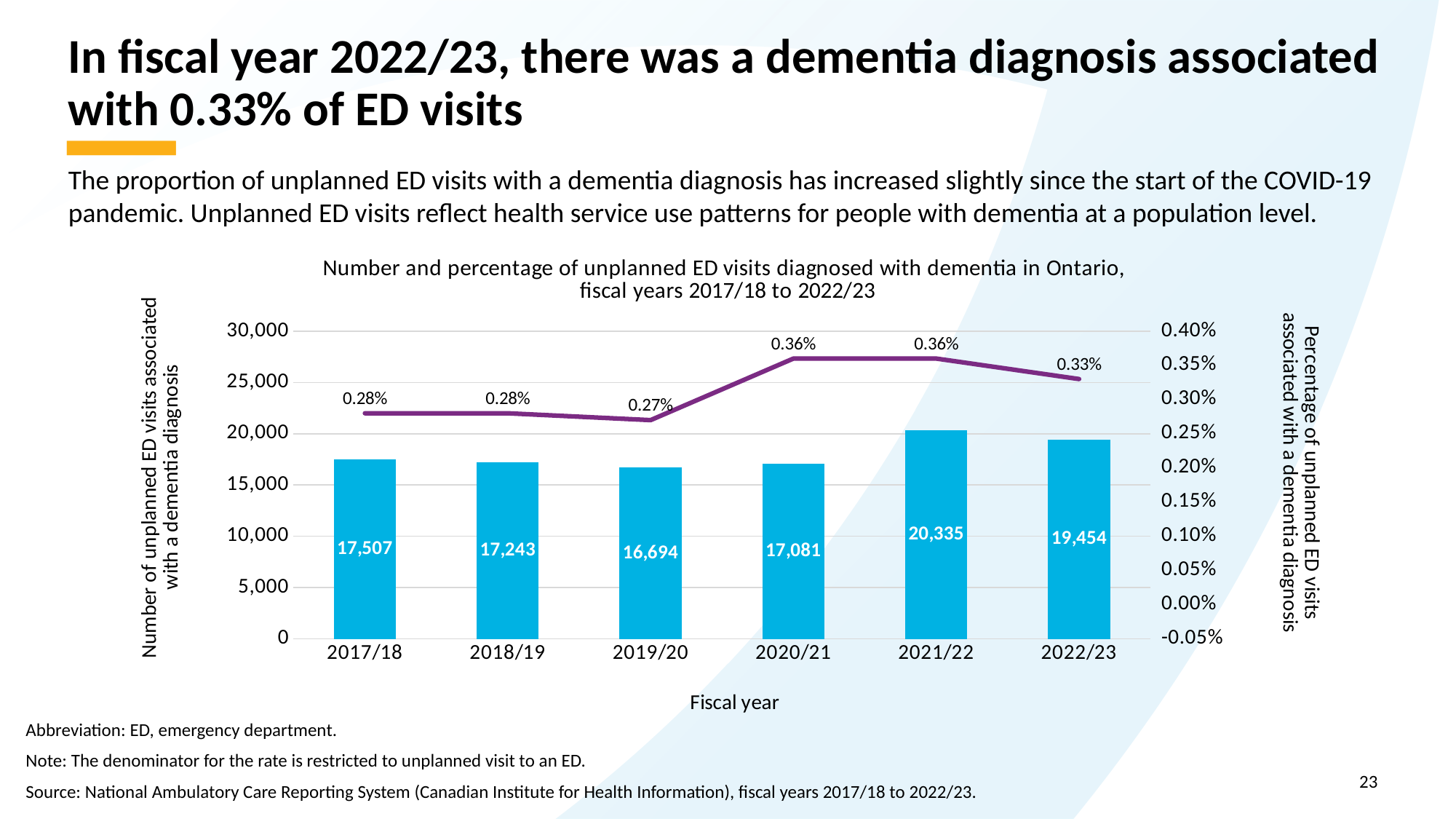
What is the number of unplanned ED visits associated with a dementia diagnosis in fiscal year 2021/22? 20,335 Which fiscal year has more unplanned ED visits associated with a dementia diagnosis, 2018/19 or 2020/21? 2018/19 What kind of chart is used to show the number of unplanned ED visits associated with a dementia diagnosis? bar chart What is the number of unplanned ED visits associated with a dementia diagnosis in fiscal year 2017/18? 17,507 How does the percentage of unplanned ED visits with a dementia diagnosis change from 2019/20 to 2020/21? It rises Which fiscal year has the highest number of unplanned ED visits associated with a dementia diagnosis? 2021/22 What percentage of unplanned ED visits were associated with a dementia diagnosis in fiscal year 2019/20? 0.27% How many fiscal years are shown on the x axis of the chart? 6 Is the number of unplanned ED visits with a dementia diagnosis in 2022/23 greater or less than 20,000? less What is the label of the right-hand vertical axis of the chart? Percentage of unplanned ED visits associated with a dementia diagnosis Which fiscal year has the lowest number of unplanned ED visits associated with a dementia diagnosis? 2019/20 What is the difference in the number of unplanned ED visits with a dementia diagnosis between fiscal years 2021/22 and 2022/23? 881